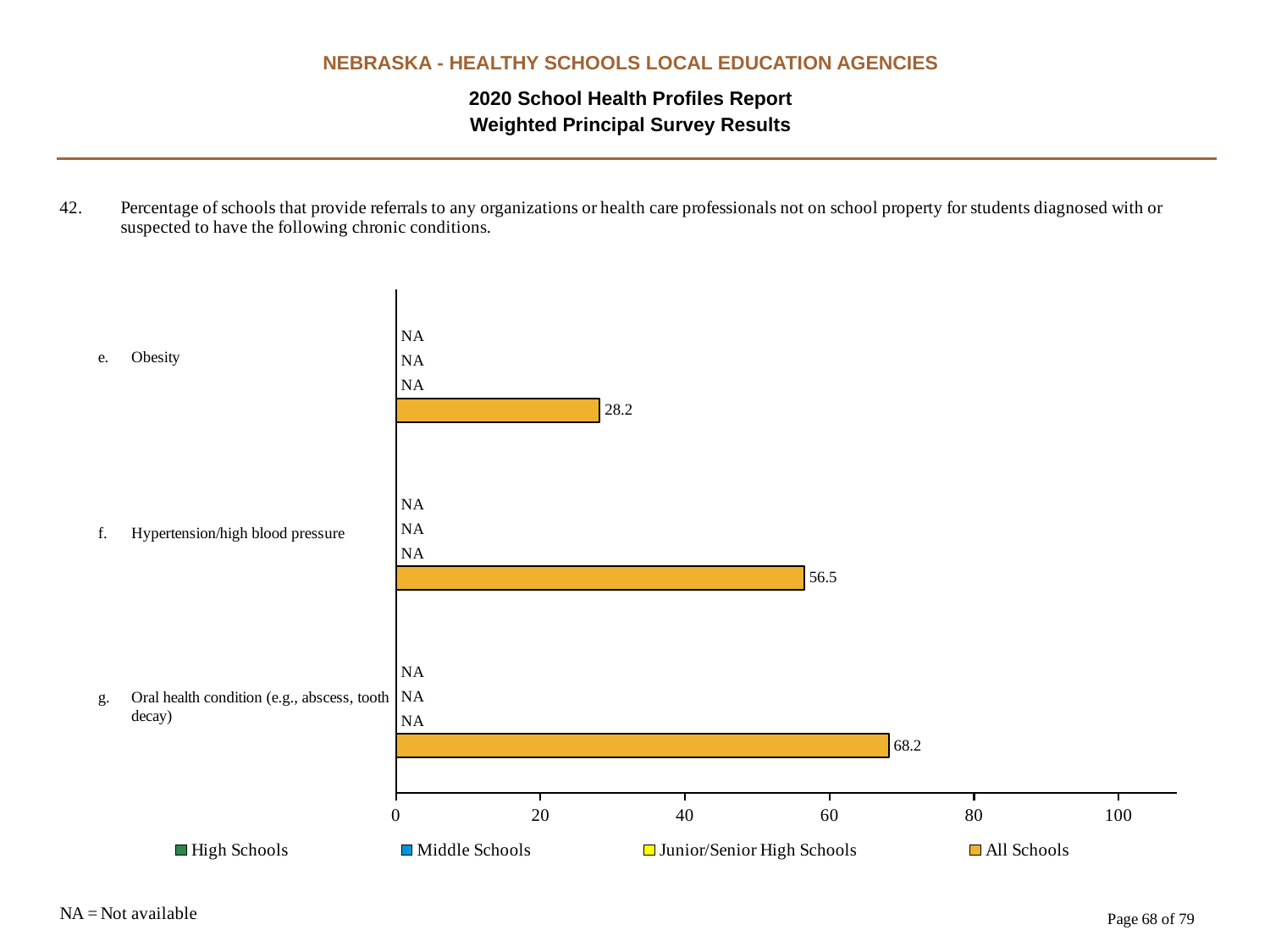
How many chronic conditions are listed on the chart? 3 Is the All Schools value for Hypertension/high blood pressure greater or less than 60? less Which condition has the highest All Schools value? Oral health condition (e.g., abscess, tooth decay) What is the All Schools value for Oral health condition (e.g., abscess, tooth decay)? 68.2 What is the difference between the All Schools values for Oral health condition and Obesity? 40.0 Which is larger, the All Schools value for Hypertension/high blood pressure or for Obesity? Hypertension/high blood pressure What is the difference between the All Schools values for Hypertension/high blood pressure and Obesity? 28.3 What is the All Schools value for Hypertension/high blood pressure? 56.5 How many series does the legend list? 4 What kind of chart is shown on the slide? bar chart Which condition has the lowest All Schools value? Obesity What is the All Schools value for Obesity? 28.2